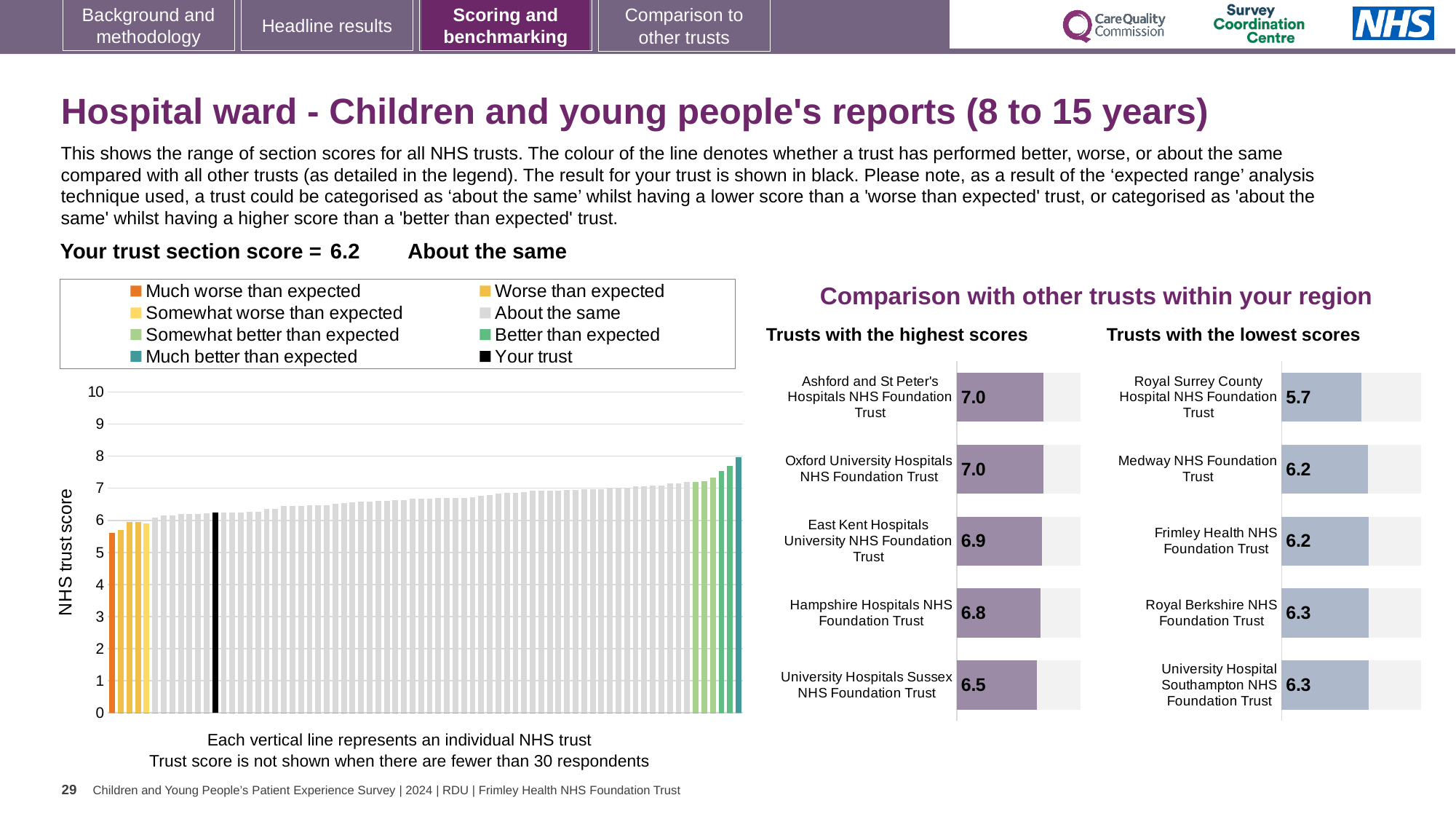
In the 'Trusts with the lowest scores' chart, which trust has the lowest score? Royal Surrey County Hospital NHS Foundation Trust What type of chart is the large chart on the left showing NHS trust scores? bar chart In the large chart on the left, what is the label on the vertical axis? NHS trust score In the 'Trusts with the highest scores' chart, which trust has the lowest score? University Hospitals Sussex NHS Foundation Trust In the 'Trusts with the lowest scores' chart, how many trusts are shown? 5 In the 'Trusts with the lowest scores' chart, which has the larger score: Royal Surrey County Hospital NHS Foundation Trust or Medway NHS Foundation Trust? Medway NHS Foundation Trust In the large chart on the left, do the trust scores rise or fall from left to right? rise In the large chart on the left, how many entries does the legend list? 8 In the large chart on the left, is the value of the tallest bar greater or less than 7? greater In the 'Trusts with the highest scores' chart, what is the difference between the scores of Ashford and St Peter's Hospitals NHS Foundation Trust and University Hospitals Sussex NHS Foundation Trust? 0.5 In the 'Trusts with the highest scores' chart, what is the score for East Kent Hospitals University NHS Foundation Trust? 6.9 In the large chart on the left, is the value of the shortest bar greater or less than 6? less